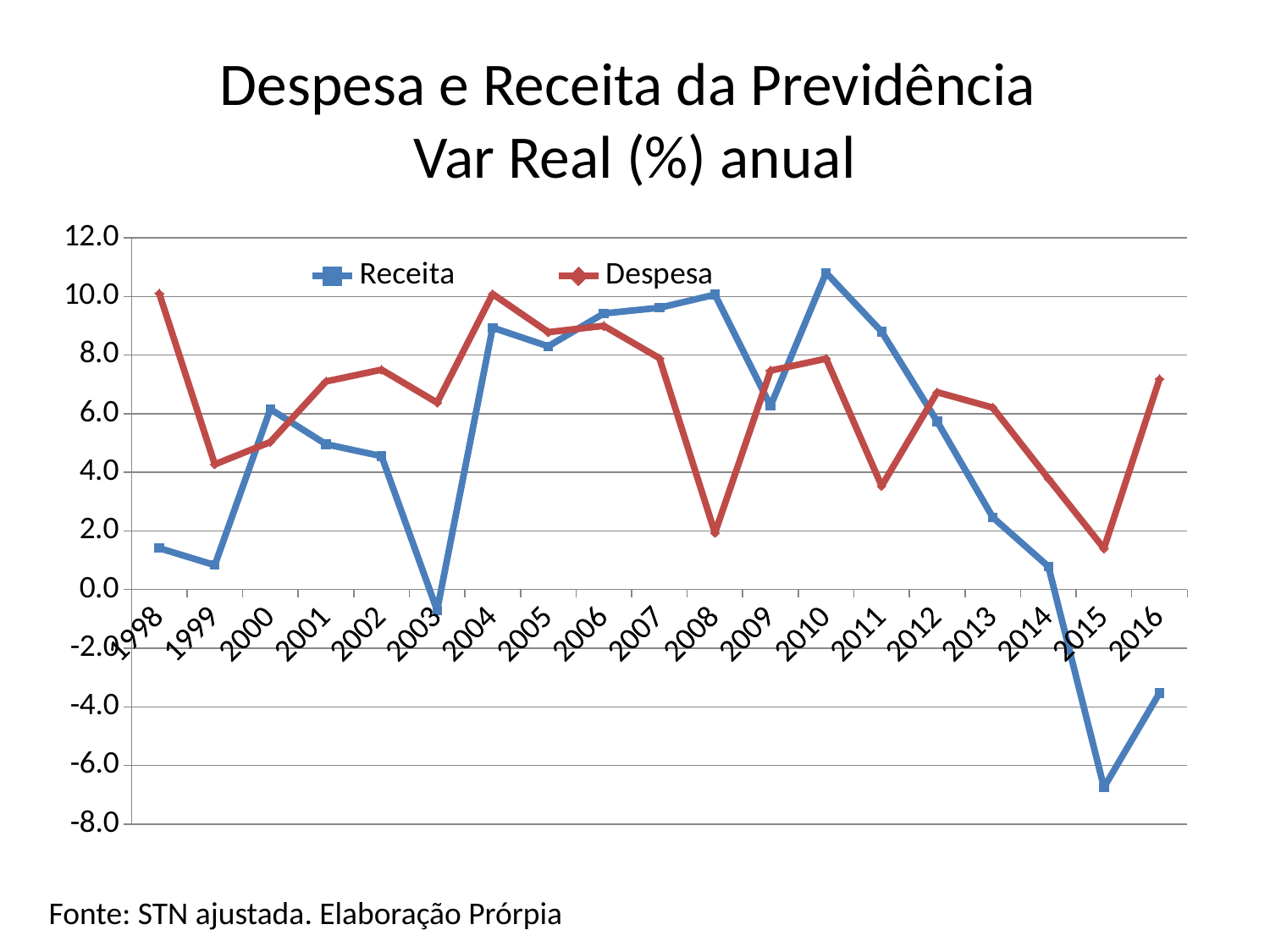
Does the Receita series rise or fall from 2010 to 2015? fall How many series does the legend list? 2 In 2015, which series has the larger value, Receita or Despesa? Despesa In which year does the Receita series reach its lowest value? 2015 How many years are plotted along the x axis? 19 Is the Despesa value for 2016 greater or less than 6.0? greater Which colour is used for the Despesa series? red Is the Despesa value for 2011 greater or less than 4.0? less What kind of chart is shown on the slide? line chart In which year does the Receita series reach its highest value? 2010 Is the Receita value for 2015 greater or less than -6.0? less